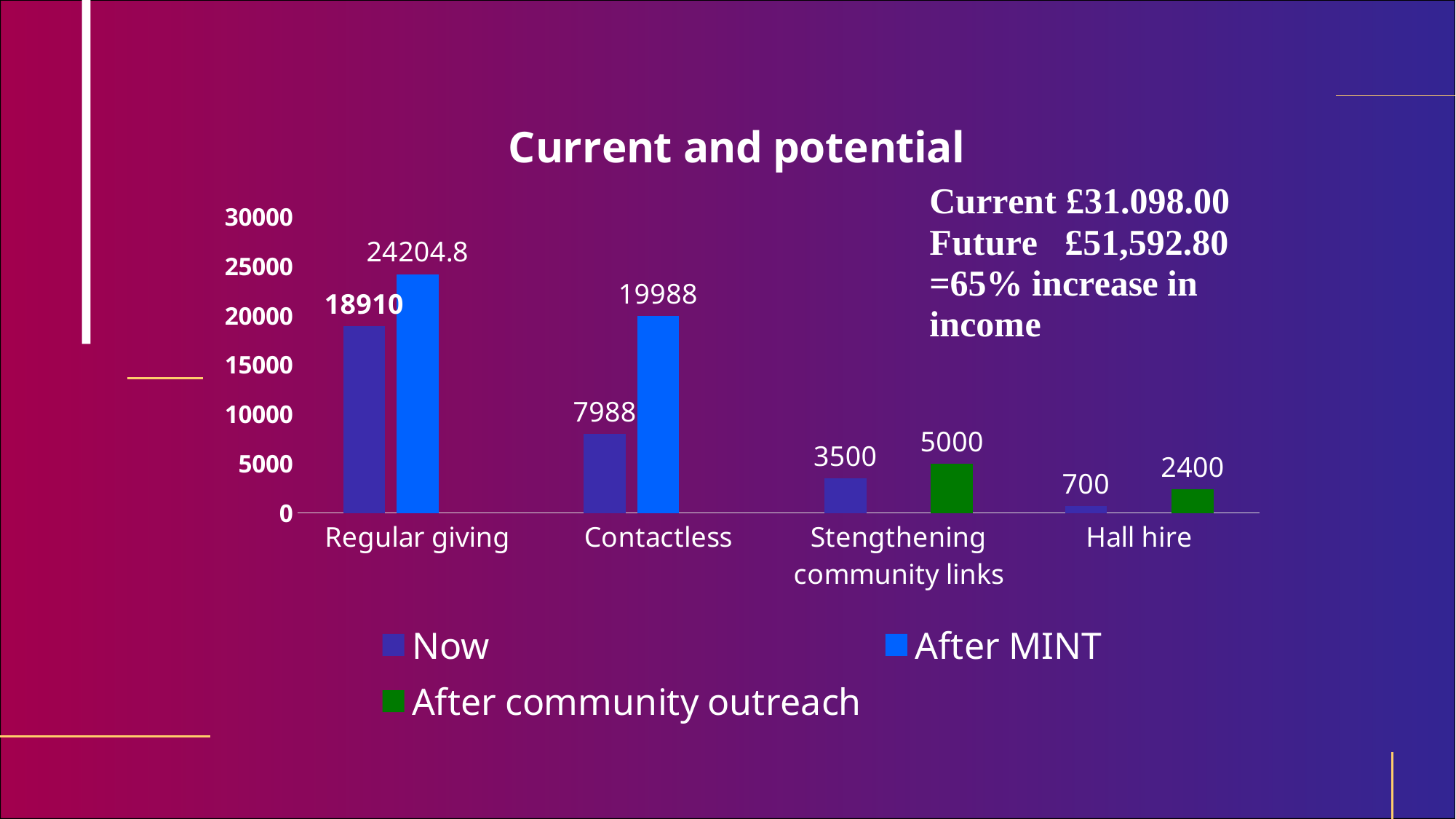
What type of chart is shown on the slide? Bar chart What is the difference between the 'After MINT' and 'Now' values for Contactless? 12000 What is the title of the chart? Current and potential Is the 'After MINT' value for Regular giving greater or less than 25000? less How many categories are shown on the x axis? 4 What is the 'After MINT' value for Contactless? 19988 What is the 'After community outreach' value for Hall hire? 2400 Which category has the highest 'Now' value? Regular giving Which category has the lowest 'Now' value? Hall hire What is the 'Now' value for Regular giving? 18910 How many series does the legend list? 3 Which is larger: the 'Now' value for Contactless or the 'After community outreach' value for Stengthening community links? Now value for Contactless